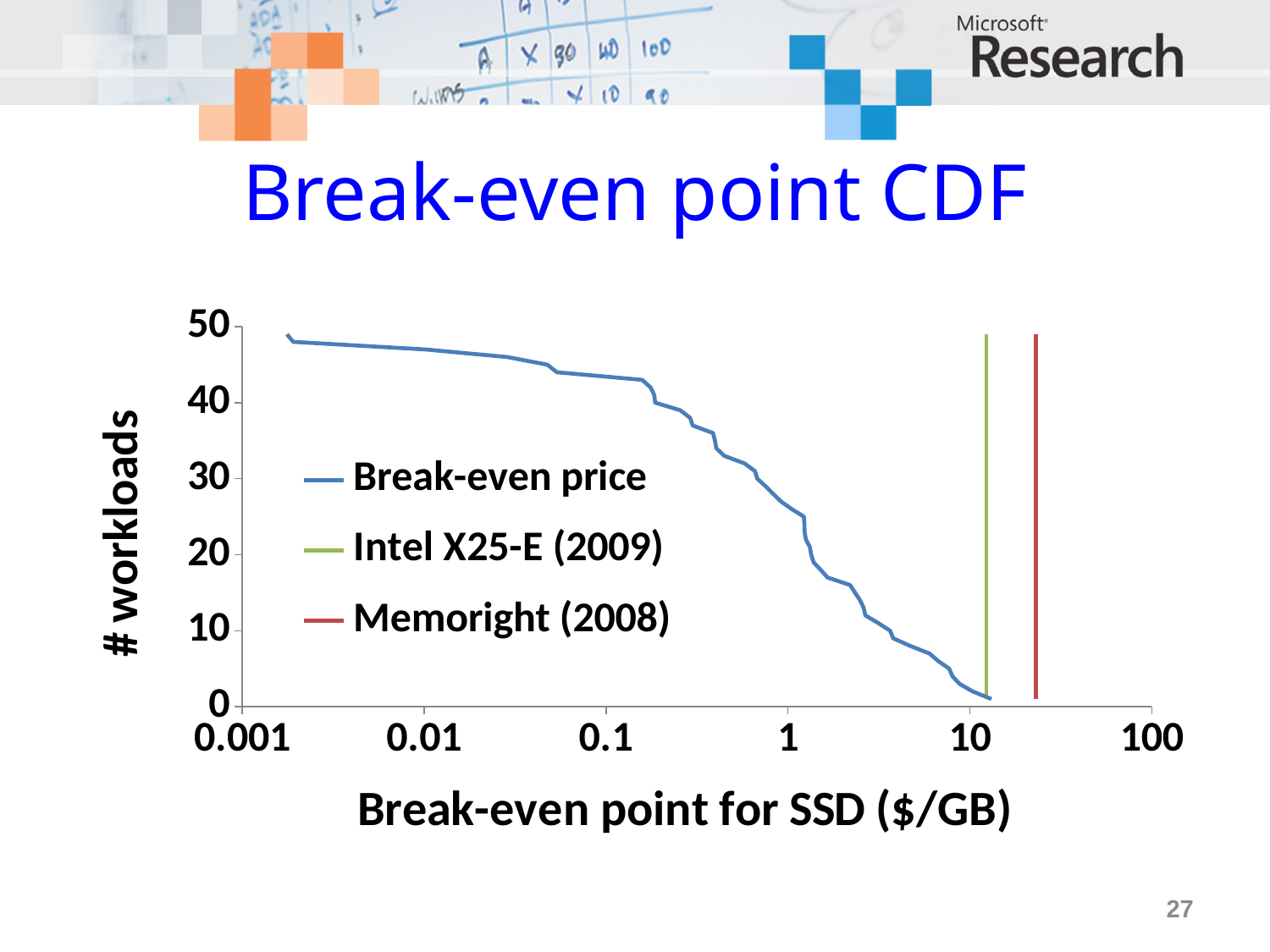
Which vertical line lies at a higher $/GB value, Intel X25-E (2009) or Memoright (2008)? Memoright (2008) What is the label of the x axis? Break-even point for SSD ($/GB) Is the Break-even price value at 0.01 $/GB greater or less than 40 workloads? greater How many series does the legend list? 3 How many tick labels are shown on the x axis? 6 What is the title of the chart? Break-even point CDF Is the Break-even price value at 1 $/GB greater or less than 30 workloads? less Does the Break-even price curve rise or fall as the break-even point increases along the x axis? fall What kind of chart is shown on the slide? line chart Is the Break-even price value at 0.1 $/GB greater or less than 40 workloads? greater